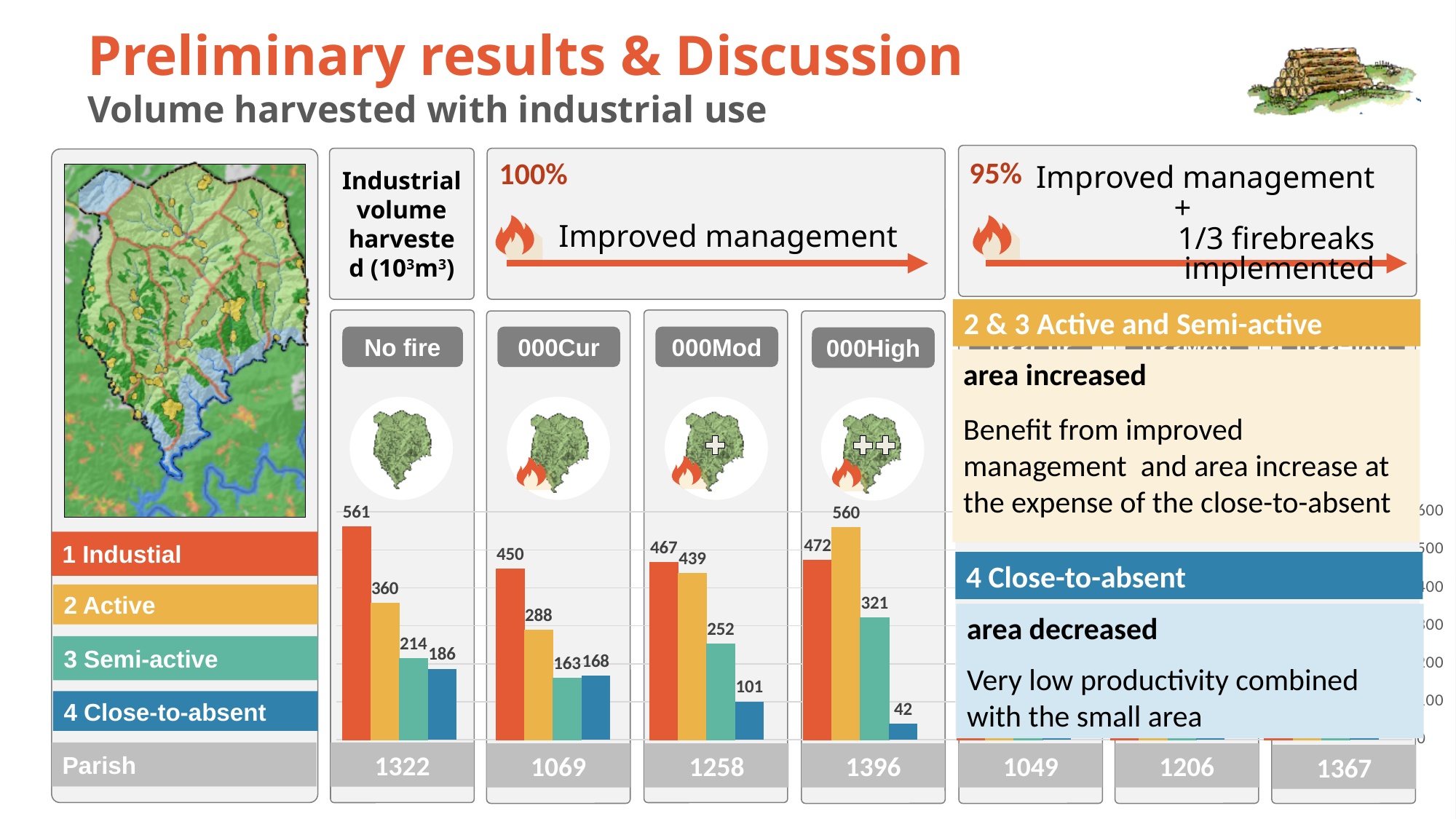
In the No fire chart, what is the value for 1 Industrial? 561 What kind of chart is used under the No fire heading? Bar chart How many bars are shown in the 000Mod chart? 4 In the 000High chart, which category has the lowest value? 4 Close-to-absent What total is printed beneath the 000High chart? 1396 In the 000Cur chart, what is the value for 2 Active? 288 In the 000Cur chart, which is larger: 3 Semi-active or 4 Close-to-absent? 4 Close-to-absent In the 000Mod chart, what is the value for 4 Close-to-absent? 101 In the No fire chart, what is the difference between the 1 Industrial value and the 2 Active value? 201 In the 000High chart, what is the value for 3 Semi-active? 321 In the 000Mod chart, what is the difference between the 1 Industrial value and the 2 Active value? 28 In the 000High chart, which category has the highest value? 2 Active